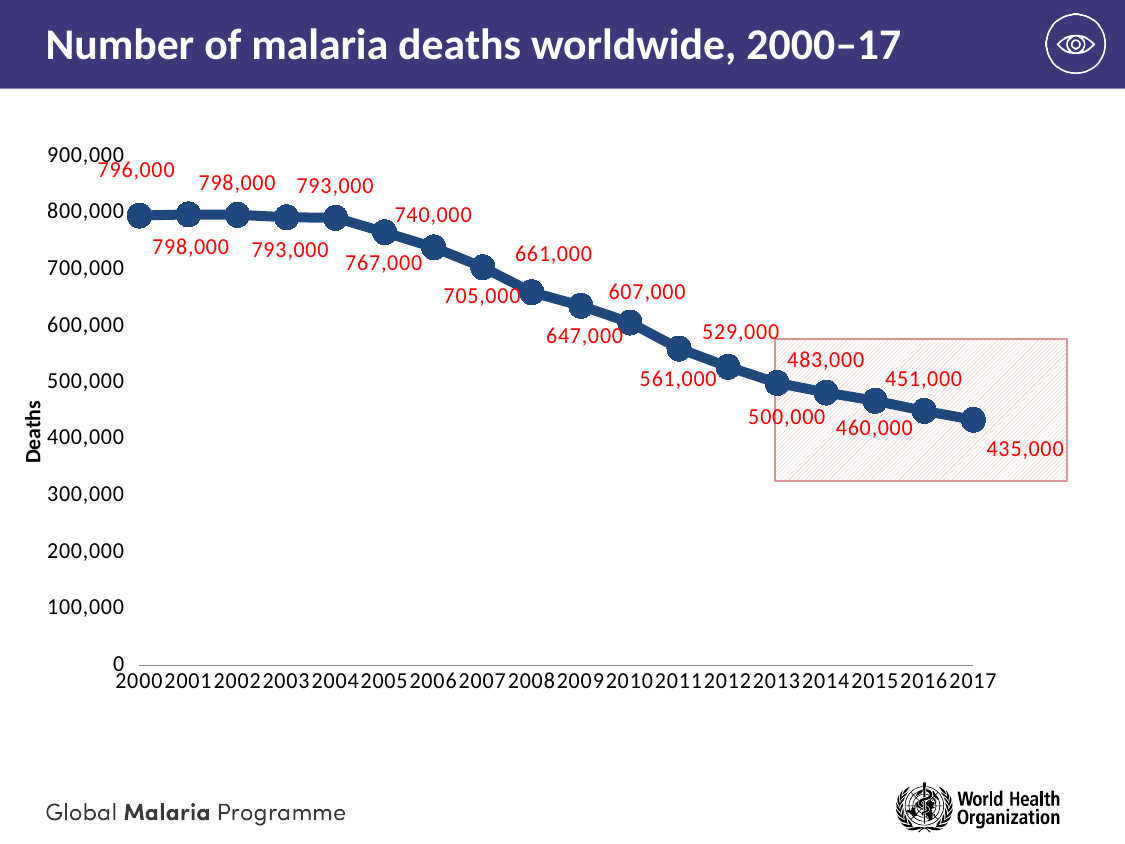
What type of chart is shown on the slide? Line chart What is the difference in malaria deaths between 2005 and 2006? 27,000 How many years (data points) are plotted on the chart? 18 Which year has the lowest number of malaria deaths? 2017 What is the number of malaria deaths worldwide in 2017? 435,000 What is the number of malaria deaths worldwide in 2000? 796,000 What is the difference in malaria deaths between 2000 and 2017? 361,000 Do the values rise or fall from 2000 to 2017? Fall Which year had more malaria deaths, 2008 or 2012? 2008 What is the label on the vertical axis? Deaths What is the number of malaria deaths worldwide in 2010? 607,000 What is the number of malaria deaths worldwide in 2013? 500,000